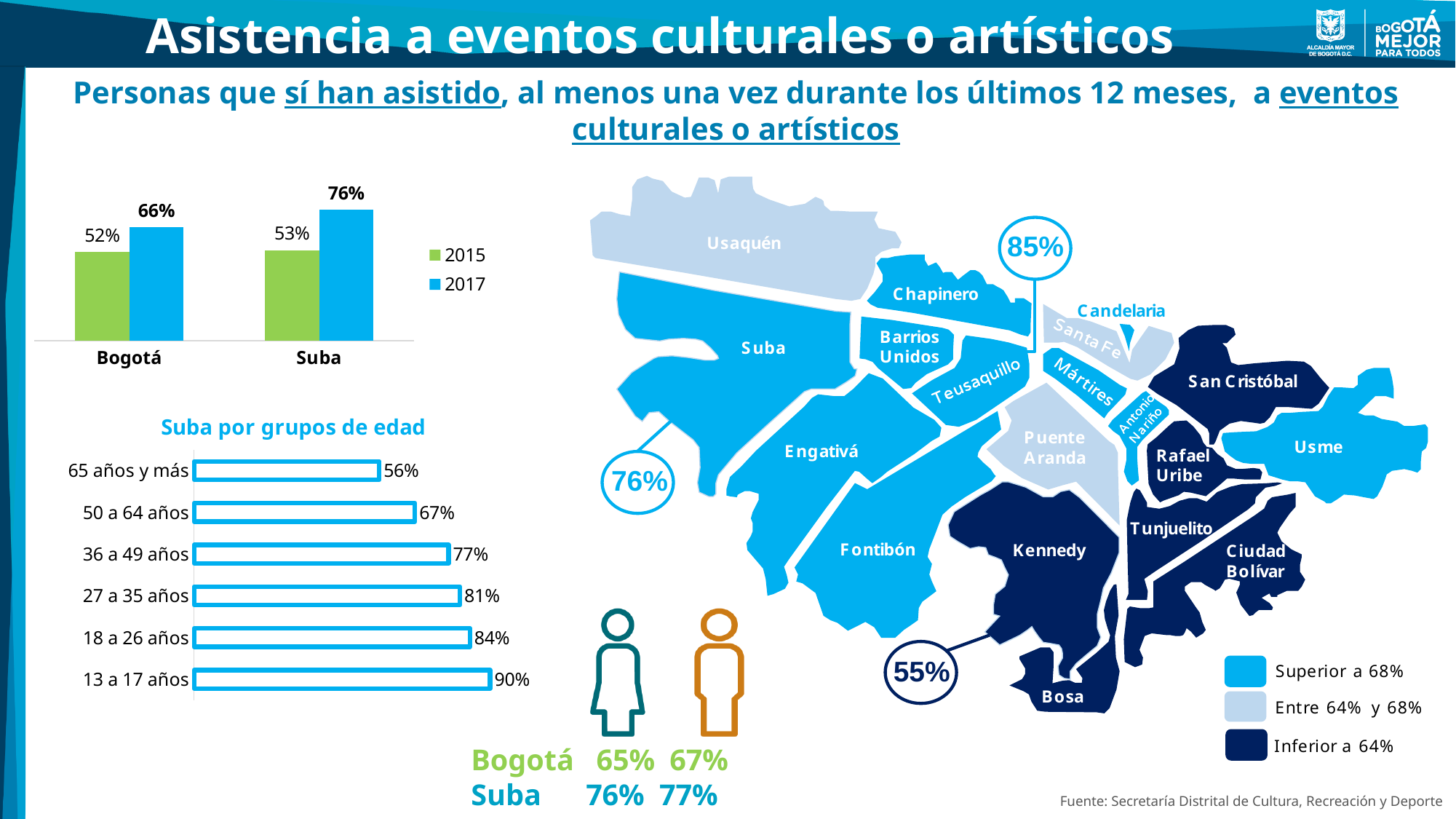
What kind of chart is 'Suba por grupos de edad'? Bar chart In the top-left bar chart, which colour represents 2015? Green In the chart 'Suba por grupos de edad', what is the difference between the values for 13 a 17 años and 65 años y más? 34 percentage points In the top-left bar chart, which is larger, the 2017 value for Bogotá or the 2017 value for Suba? Suba In the top-left bar chart, what is the value for Suba in 2017? 76% In the chart 'Suba por grupos de edad', which age group has the lowest value? 65 años y más In the top-left bar chart, how many series does the legend list? 2 In the top-left bar chart, what is the difference between the 2017 and 2015 values for Bogotá? 14 percentage points In the top-left bar chart, what is the value for Bogotá in 2015? 52% In the chart 'Suba por grupos de edad', which age group has the highest value? 13 a 17 años In the chart 'Suba por grupos de edad', how many age groups are shown? 6 In the chart 'Suba por grupos de edad', what is the value for 36 a 49 años? 77%